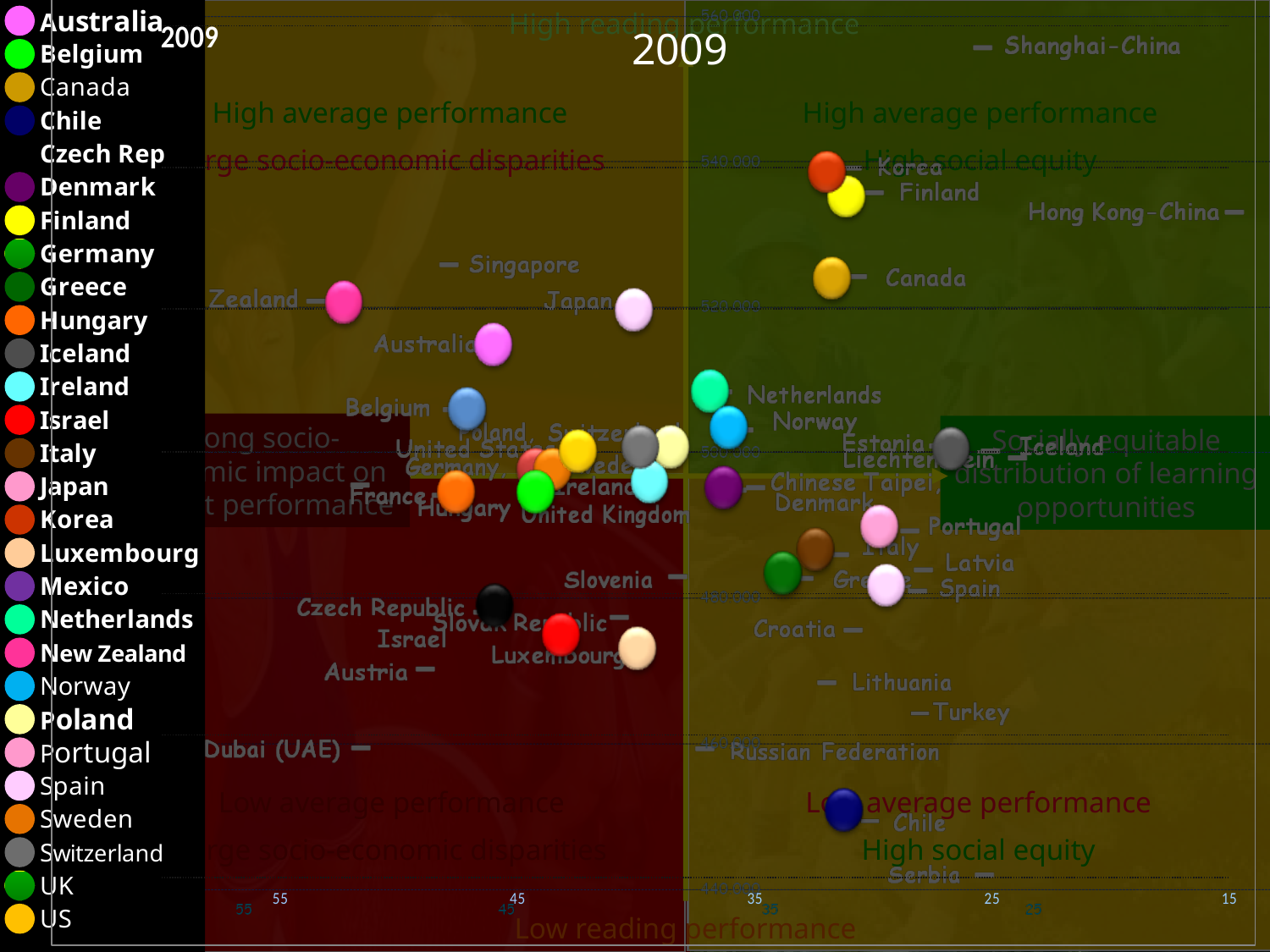
Is the horizontal-axis value for New Zealand greater or less than 45? greater Is the horizontal-axis value for Luxembourg greater or less than 35? greater Which marker is higher on the vertical axis, Finland or Luxembourg? Finland Which marker is higher on the vertical axis, Korea or Chile? Korea Which country's marker is lowest on the vertical axis? Chile What year is shown as the chart's title? 2009 Which marker is further to the left on the chart, New Zealand or Korea? New Zealand How many countries does the legend on the left list? 28 Is the horizontal-axis value for Canada greater or less than 35? less Which country's marker is highest on the vertical axis? Korea What kind of chart is shown on the slide? scatter chart